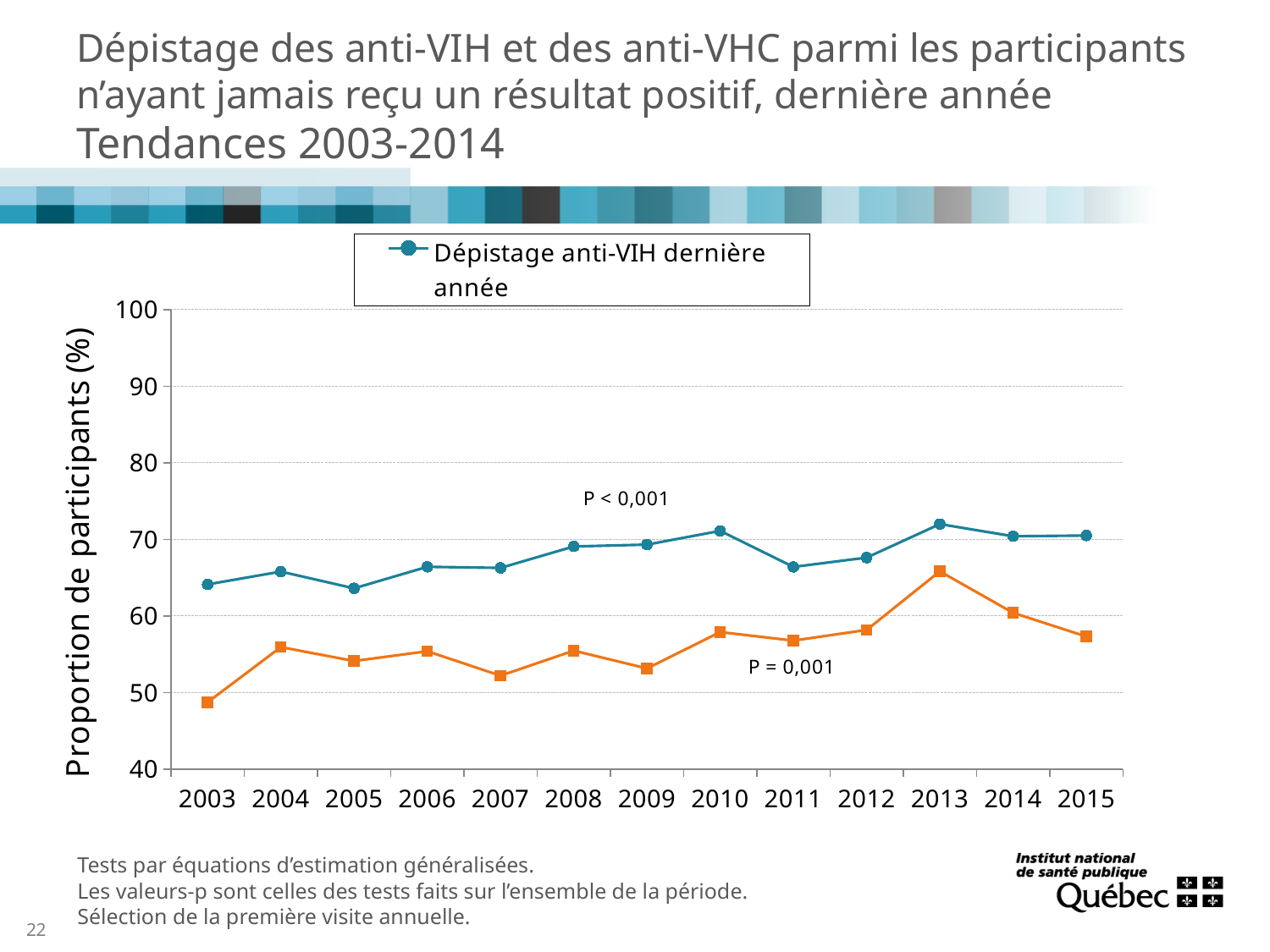
In 2013, which series has the larger value: the Dépistage anti-VIH dernière année series or the orange square-marker series? Dépistage anti-VIH dernière année In which year does the orange square-marker series reach its lowest value? 2003 What is the series name shown in the legend? Dépistage anti-VIH dernière année Is the value of the orange square-marker series in 2003 greater or less than 50? less How many series does the legend list? 1 Does the orange square-marker series rise or fall from 2013 to 2015? fall What is the label of the y axis? Proportion de participants (%) What kind of chart is shown on the slide? line chart How many years are plotted along the x axis? 13 Is the value for Dépistage anti-VIH dernière année in 2010 greater or less than 70? greater In which year does the orange square-marker series reach its highest value? 2013 In which year does the Dépistage anti-VIH dernière année series reach its highest value? 2013